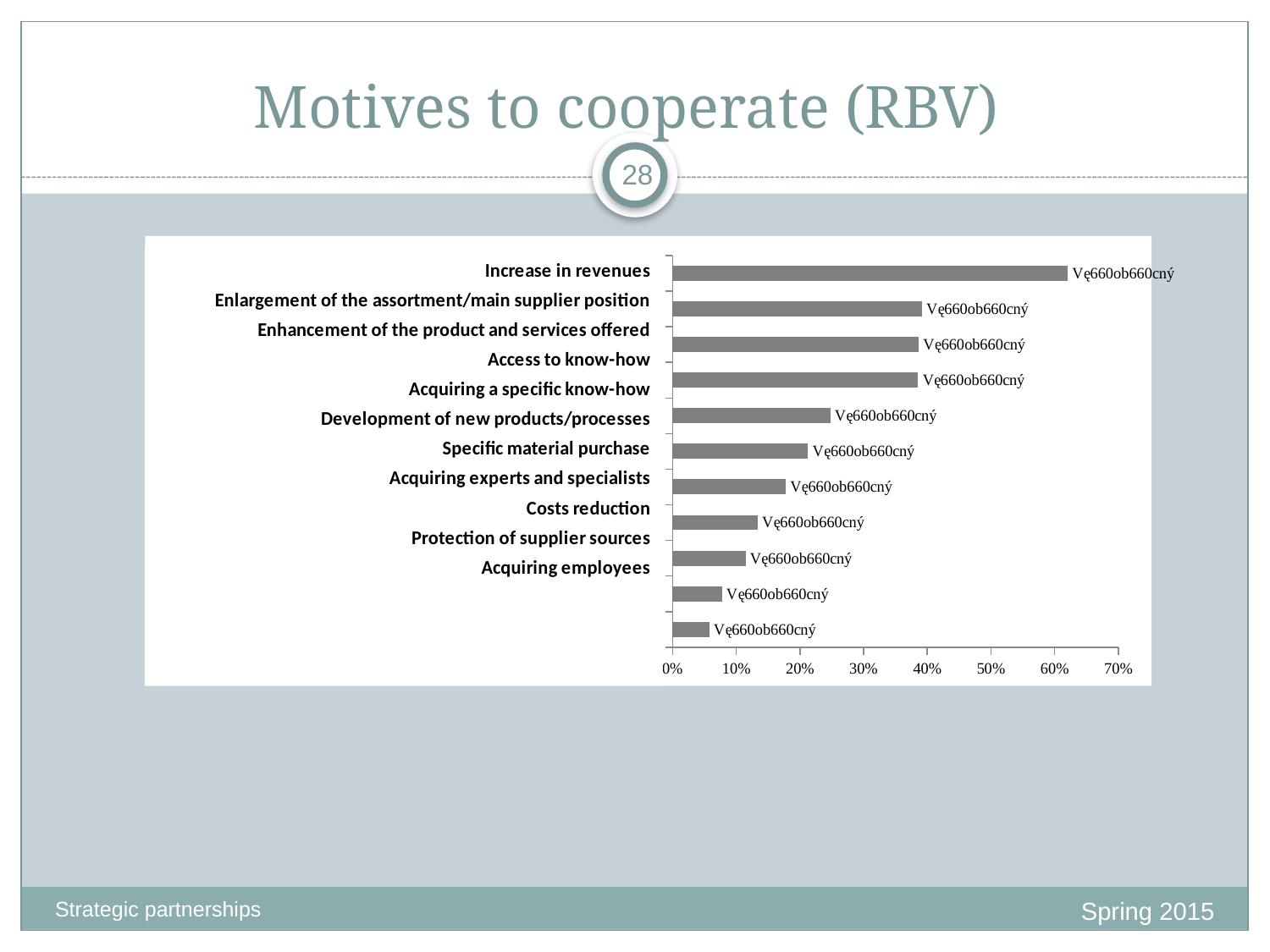
Do the bar lengths increase or decrease going from the top of the chart to the bottom? decrease Which motive has the longest bar in the chart? Increase in revenues Is the value of the top bar larger or smaller than the value of the second bar from the top? larger Is the value of the shortest (bottom) bar greater or less than 10%? less How many bars are plotted in the chart? 11 Is the value for Increase in revenues greater or less than 50%? greater What is the title of the slide containing the chart? Motives to cooperate (RBV) What kind of chart is shown on the slide? bar chart What is the highest value shown on the horizontal axis of the chart? 70%